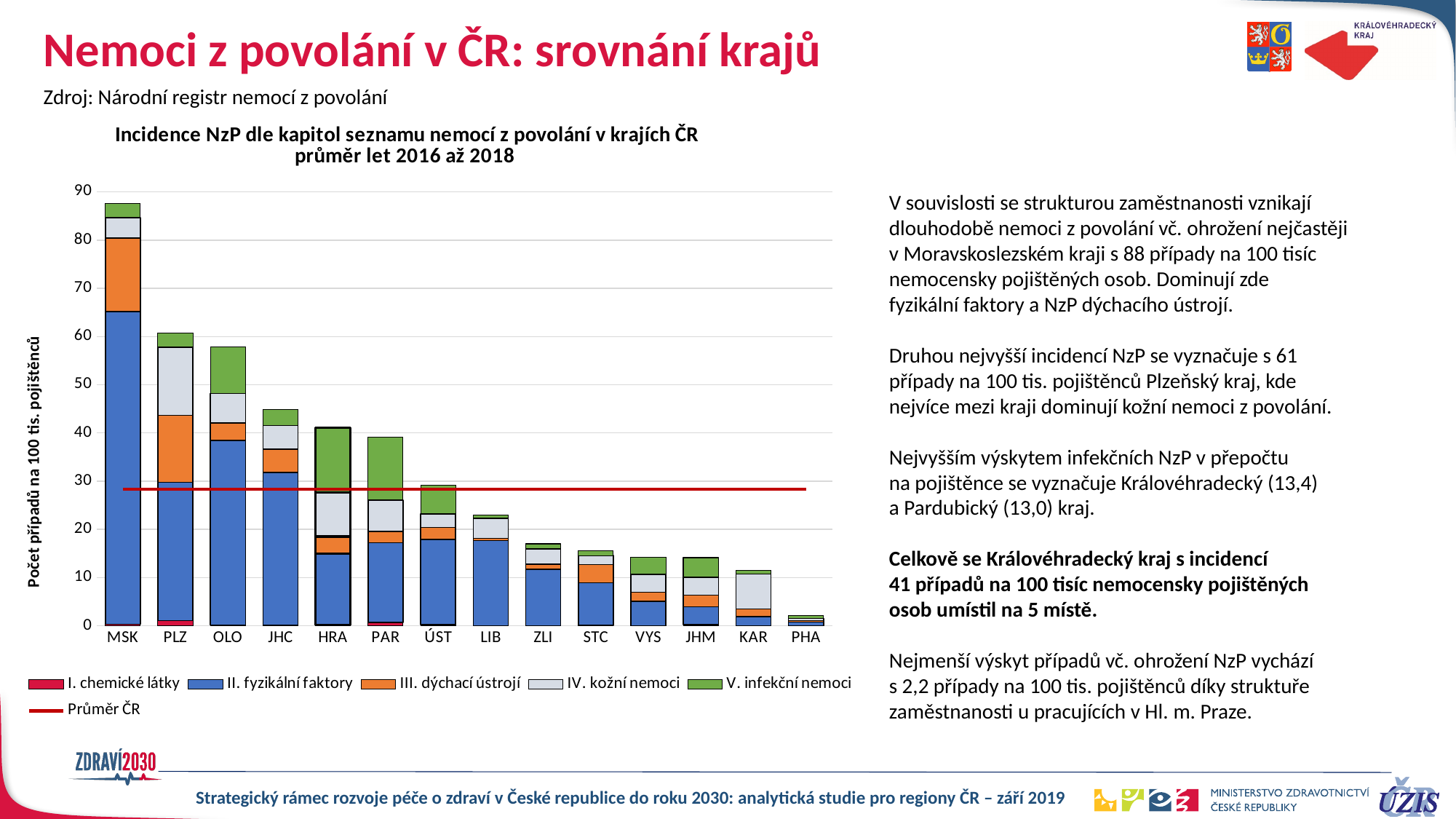
Do the total bar values rise or fall from left to right along the x axis? fall Is the total value for LIB greater or less than 30? less How many entries does the chart legend list? 6 What kind of chart is shown on the slide? bar chart Which region has the highest total incidence in the chart? MSK Is the total value for PHA greater or less than 10? less Is the total value for MSK greater or less than 80? greater Which region has the lowest total incidence in the chart? PHA How many regions (categories) are shown on the x axis of the chart? 14 What colour represents the series 'V. infekční nemoci' in the chart? green Which region has the larger total bar, OLO or JHC? OLO